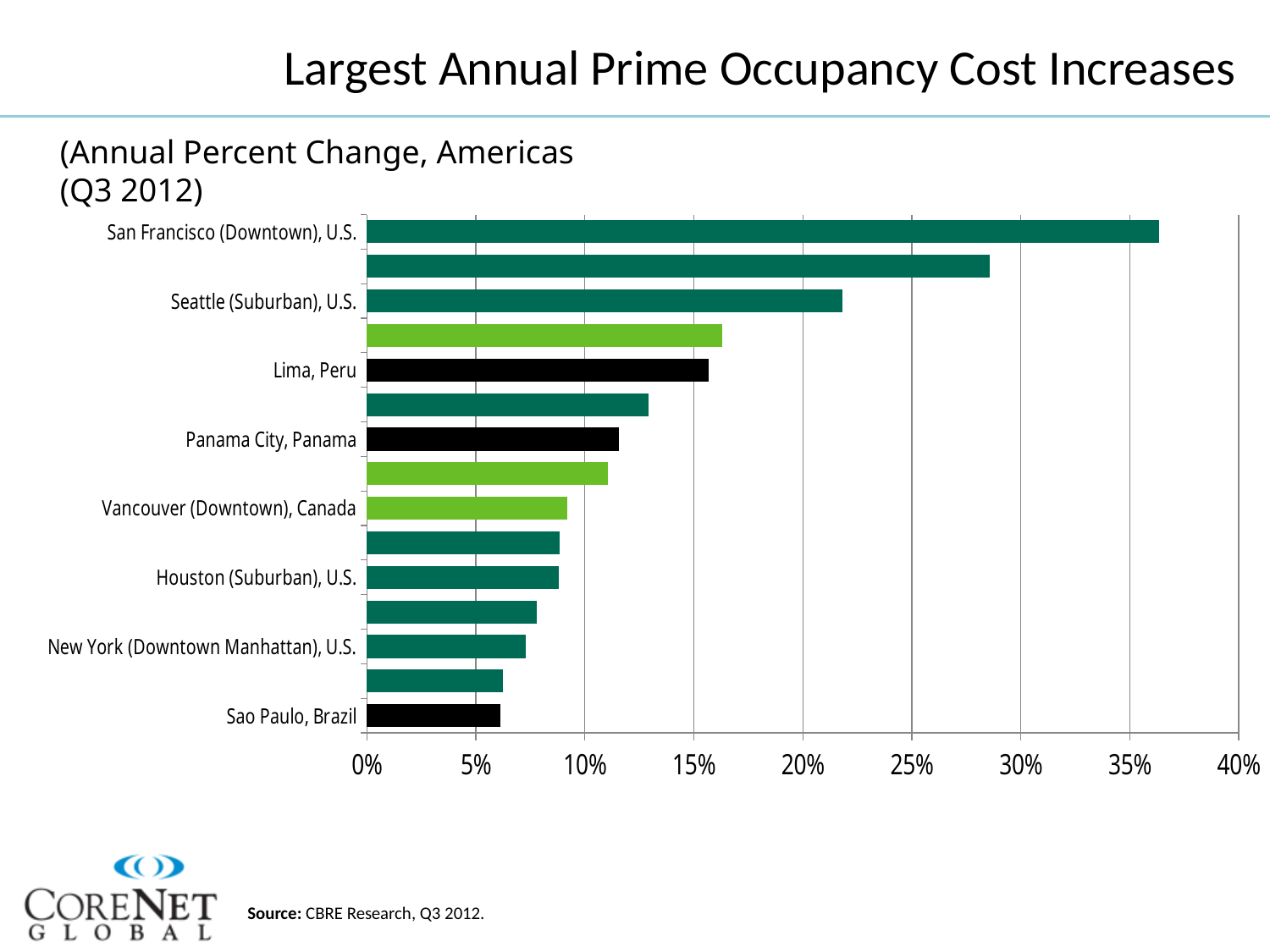
Which category has the highest annual percent change? San Francisco (Downtown), U.S. What kind of chart is shown on the slide? Bar chart What is the highest value shown on the horizontal axis? 40% Is the value for Vancouver (Downtown), Canada greater or less than 10%? less Is the value for Lima, Peru greater or less than 15%? greater Which is larger, the value for Seattle (Suburban), U.S. or the value for Lima, Peru? Seattle (Suburban), U.S. Do the bars get longer or shorter going from the top of the chart to the bottom? Shorter Is the value for New York (Downtown Manhattan), U.S. greater or less than 10%? less Which is larger, the value for Houston (Suburban), U.S. or the value for New York (Downtown Manhattan), U.S.? Houston (Suburban), U.S.